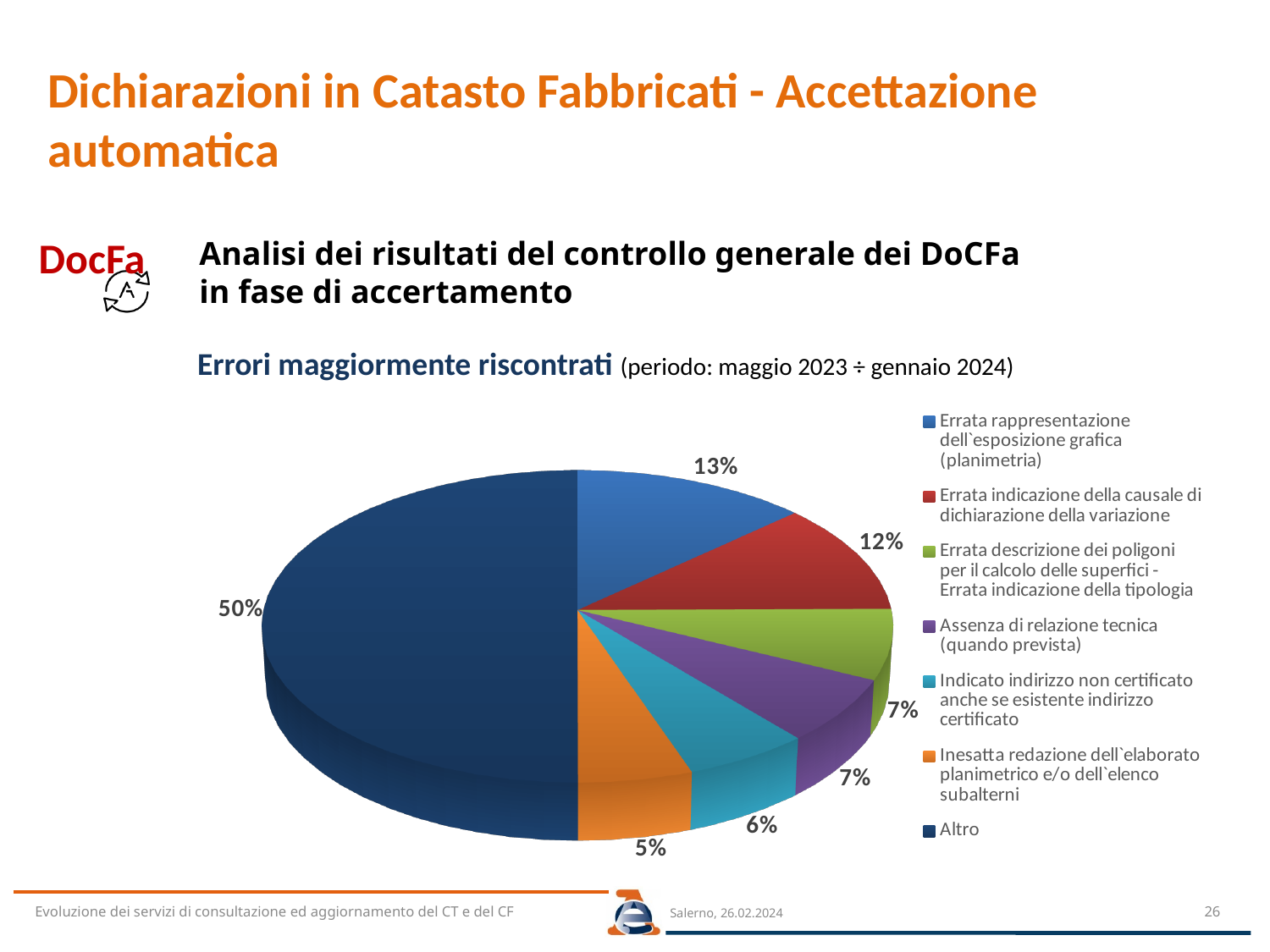
What is the value for "Inesatta redazione dell`elaborato planimetrico e/o dell`elenco subalterni"? 5% How many categories does the legend of the pie chart list? 7 Which category has the smallest slice of the pie? Inesatta redazione dell`elaborato planimetrico e/o dell`elenco subalterni What kind of chart is shown on the slide? pie chart Which category has the largest slice of the pie? Altro What is the value for "Errata rappresentazione dell`esposizione grafica (planimetria)"? 13% What is the difference between the share for "Altro" and the share for "Errata rappresentazione dell`esposizione grafica (planimetria)"? 37% Which is larger: the share for "Errata rappresentazione dell`esposizione grafica (planimetria)" or the share for "Errata indicazione della causale di dichiarazione della variazione"? Errata rappresentazione dell`esposizione grafica (planimetria) What is the value for "Errata indicazione della causale di dichiarazione della variazione"? 12% What is the value for "Indicato indirizzo non certificato anche se esistente indirizzo certificato"? 6% What period is indicated in the chart title "Errori maggiormente riscontrati"? maggio 2023 ÷ gennaio 2024 What share of the pie does "Altro" represent? 50%